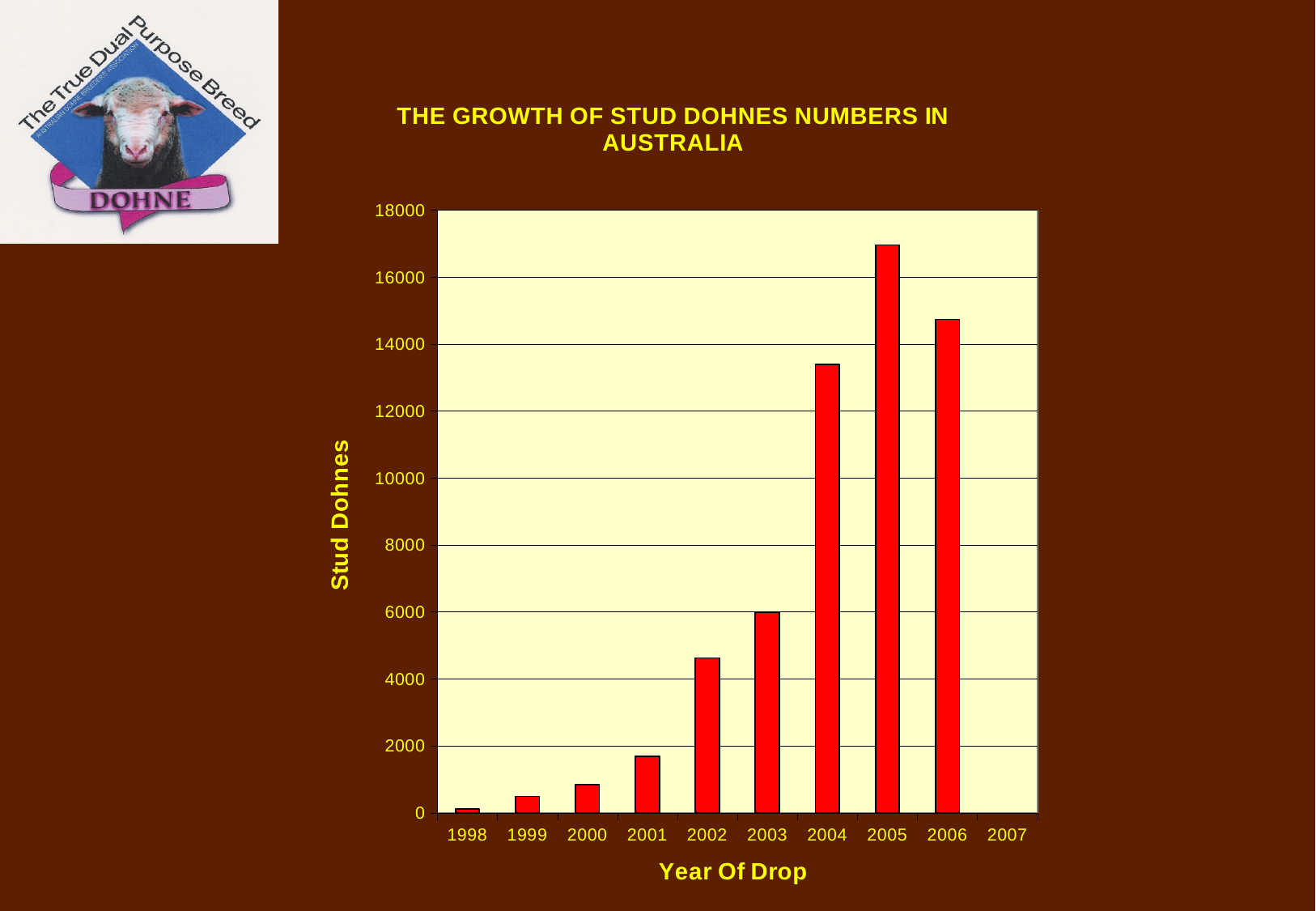
Which has more stud Dohnes, 2005 or 2006? 2005 How many years are listed along the x axis? 10 Is the value for 2002 greater or less than 4000? greater Which year of drop has the highest number of stud Dohnes? 2005 What kind of chart is shown on the slide? bar chart Is the value for 2004 greater or less than 14000? less What is the label on the x axis of the chart? Year Of Drop Is the value for 2005 greater or less than 16000? greater What is the title of the chart? THE GROWTH OF STUD DOHNES NUMBERS IN AUSTRALIA Which has more stud Dohnes, 2004 or 2006? 2006 Do the stud Dohnes numbers rise or fall from 1998 to 2005? rise